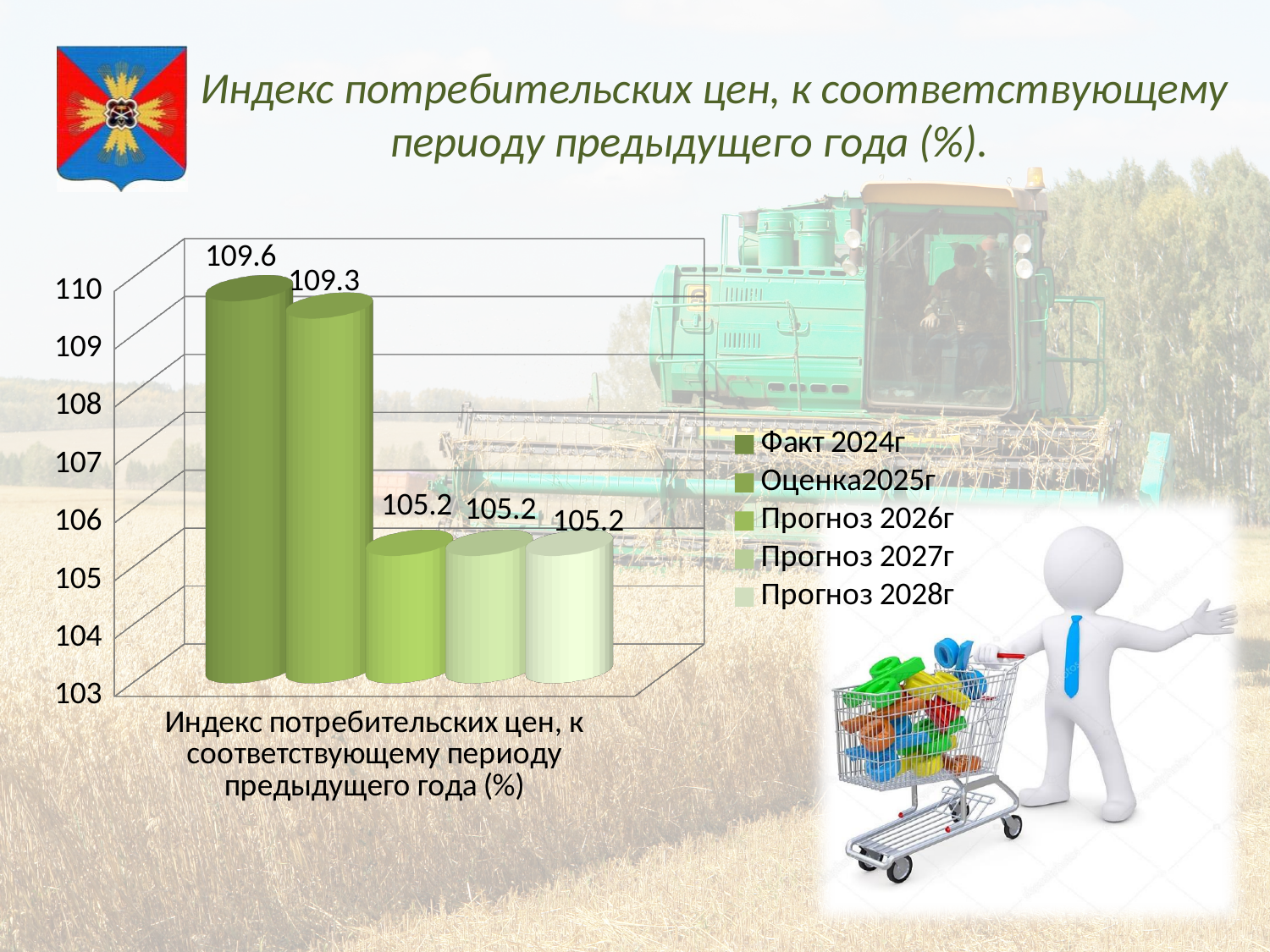
What is the difference between the values for Факт 2024г and Оценка2025г? 0.3 What is the value for Факт 2024г? 109.6 Is the value for Прогноз 2027г greater or less than 107? less Do the values rise or fall from Факт 2024г to Прогноз 2028г? fall Which series has the highest value? Факт 2024г What is the value for Прогноз 2028г? 105.2 Which is larger, the value for Факт 2024г or the value for Прогноз 2027г? Факт 2024г How many series does the legend list? 5 What is the difference between the values for Оценка2025г and Прогноз 2026г? 4.1 What kind of chart is shown on the slide? bar chart What is the value for Оценка2025г? 109.3 What is the value for Прогноз 2026г? 105.2